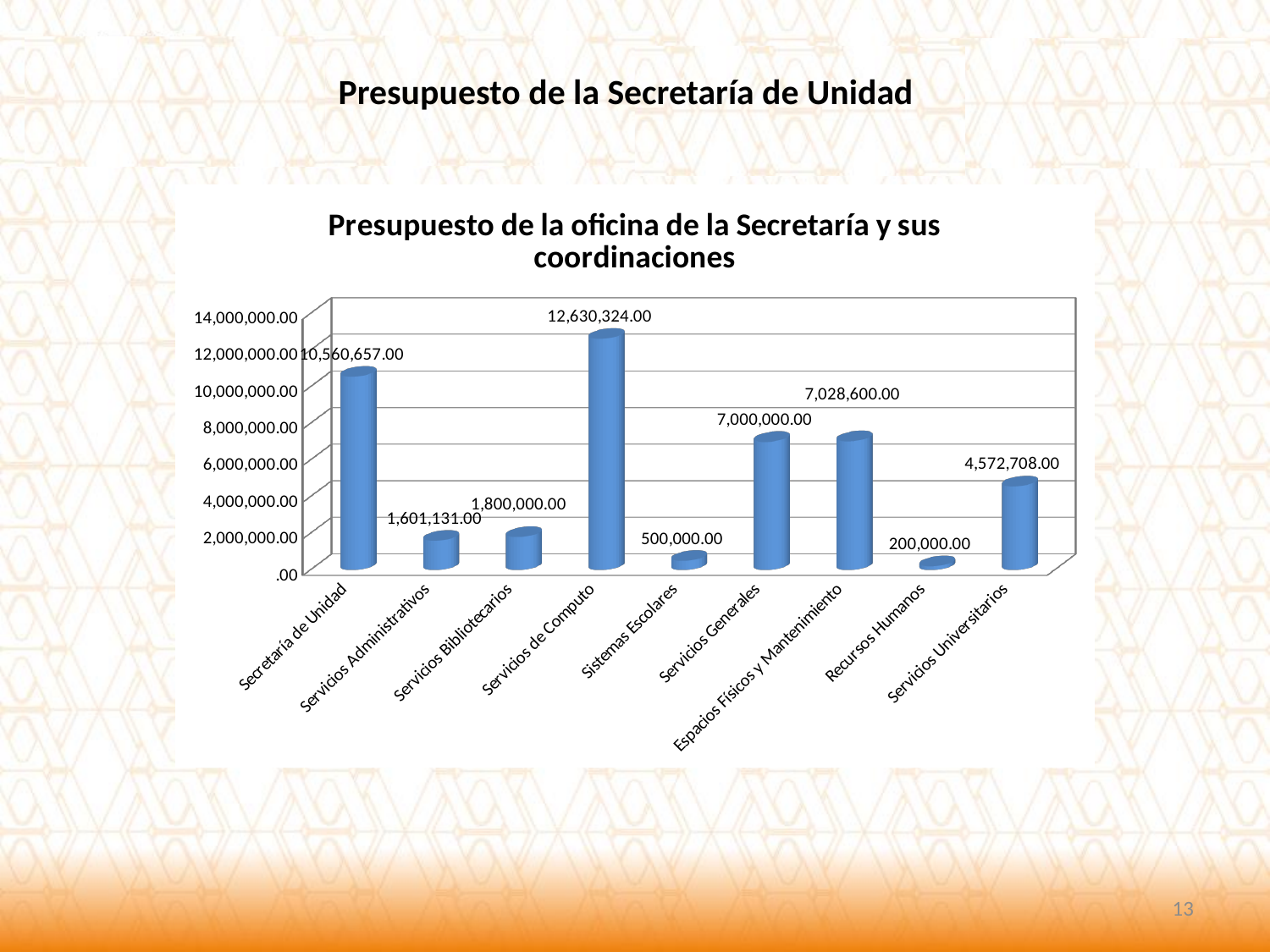
What is the budget value for Servicios de Computo? 12,630,324.00 Which has a larger budget, Servicios Universitarios or Servicios Generales? Servicios Generales What is the difference between the budgets of Servicios Bibliotecarios and Servicios Administrativos? 198,869.00 How many categories are shown in the chart? 9 What is the budget value for Recursos Humanos? 200,000.00 What type of chart is shown on the slide? Bar chart Which category has the lowest budget? Recursos Humanos Is the value for Sistemas Escolares greater or less than 2,000,000.00? less Which category has the highest budget? Servicios de Computo What is the budget value for Servicios Universitarios? 4,572,708.00 What is the difference between the budgets of Servicios de Computo and Secretaría de Unidad? 2,069,667.00 What is the budget value for Secretaría de Unidad? 10,560,657.00